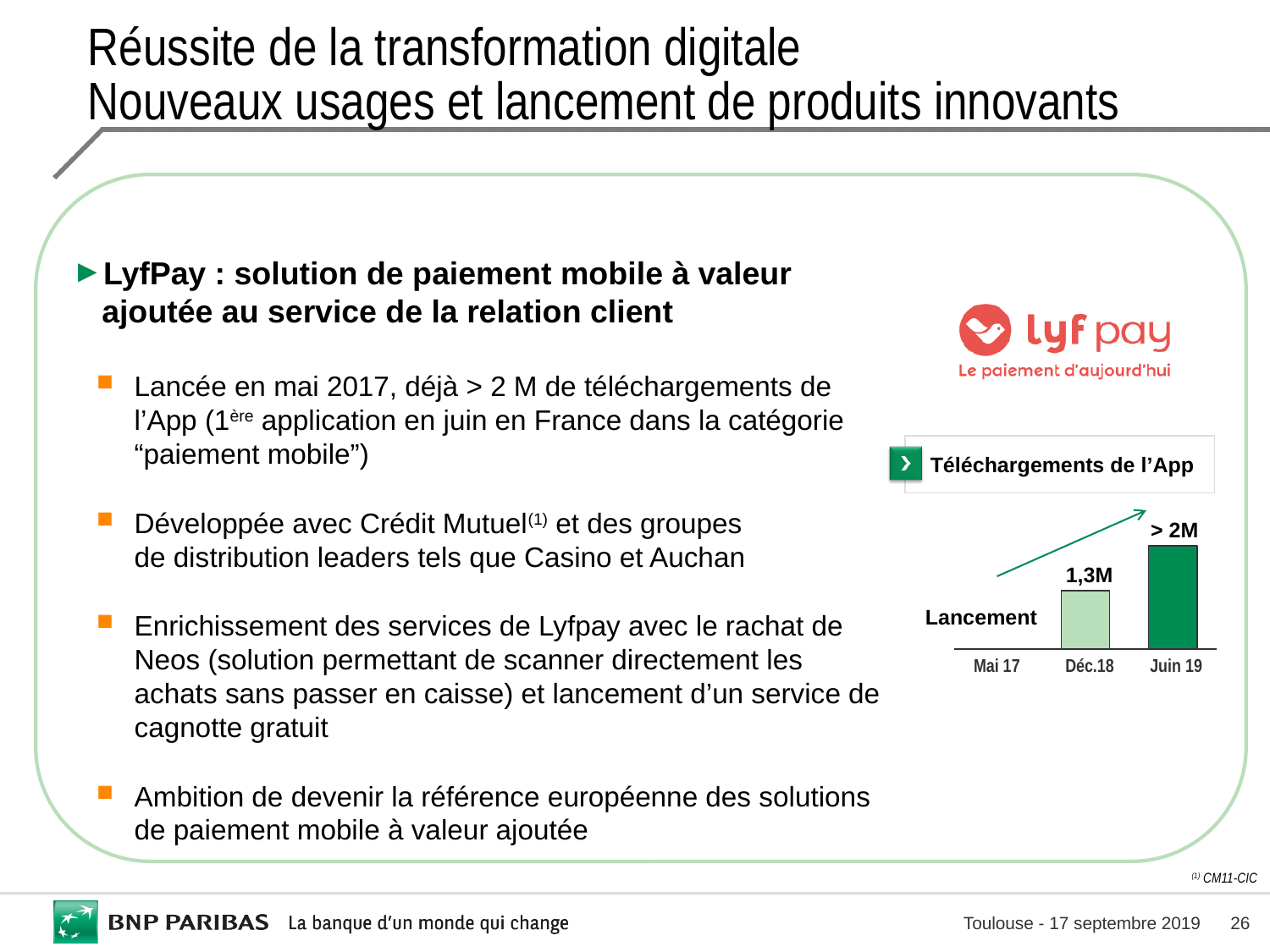
In the 'Téléchargements de l'App' chart, which period has the highest number of downloads? Juin 19 What kind of chart is the 'Téléchargements de l'App' chart? Bar chart In the 'Téléchargements de l'App' chart, what is the first period shown on the x axis? Mai 17 What is the title of the chart on the slide? Téléchargements de l'App In the 'Téléchargements de l'App' chart, which is larger: the value for Déc.18 or the value for Juin 19? Juin 19 In the 'Téléchargements de l'App' chart, what is the value shown for Juin 19? > 2M How many periods are labelled on the x axis of the 'Téléchargements de l'App' chart? 3 In the 'Téléchargements de l'App' chart, do the values rise or fall from Mai 17 to Juin 19? Rise In the 'Téléchargements de l'App' chart, what label is shown at the Mai 17 position instead of a bar? Lancement In the 'Téléchargements de l'App' chart, what is the value shown for Déc.18? 1,3M